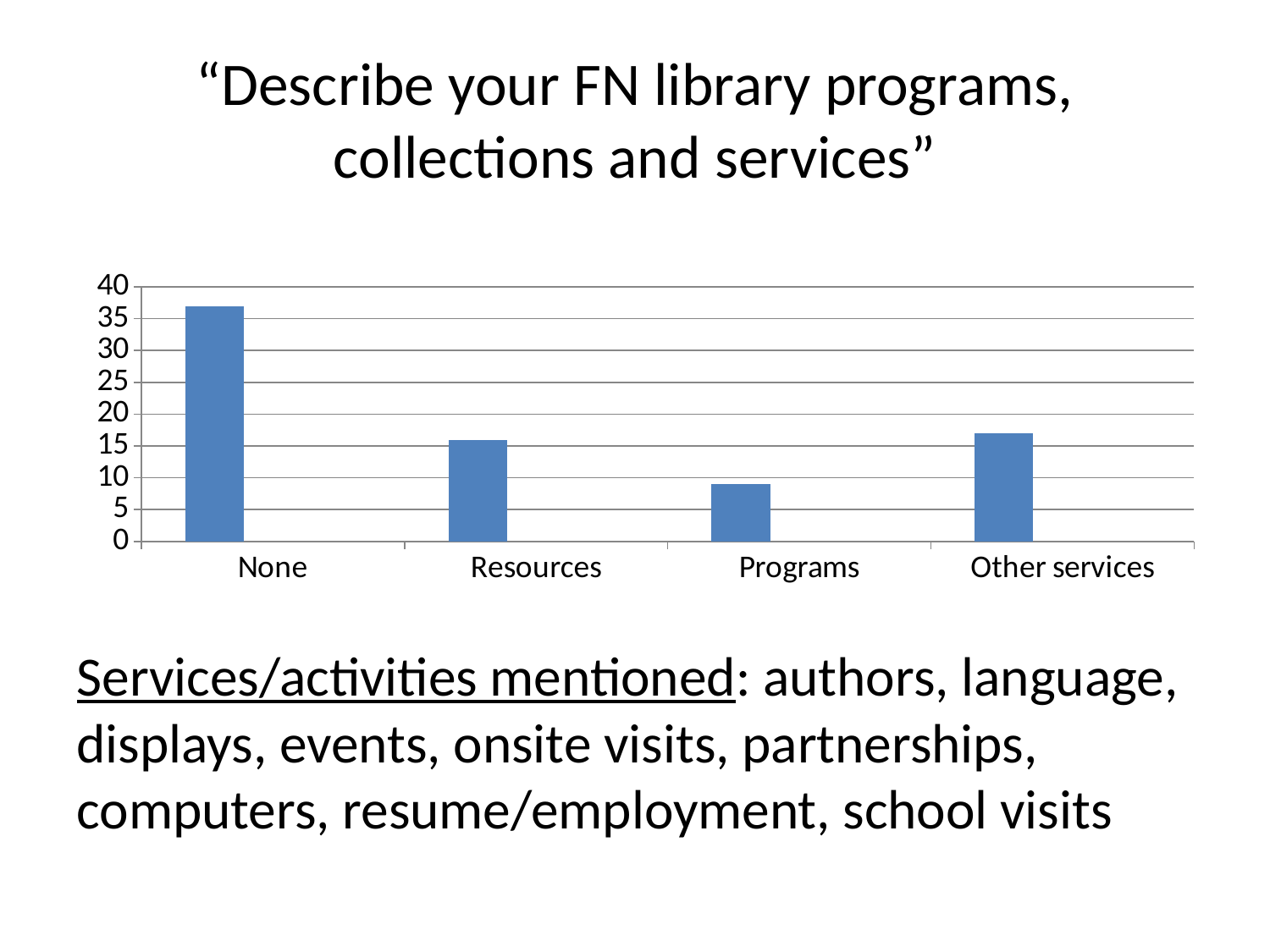
Is the value for None greater or less than 35? greater What kind of chart is shown on the slide? bar chart Is the value for Other services greater or less than 20? less How many categories are shown on the x axis of the chart? 4 Which is larger, the value for Resources or the value for Programs? Resources Which category has the highest bar? None Which is larger, the value for None or the value for Programs? None Is the value for Resources greater or less than 15? greater What is the highest value shown on the y axis of the chart? 40 Which category has the lowest bar? Programs What is the title of the slide containing the chart? "Describe your FN library programs, collections and services"